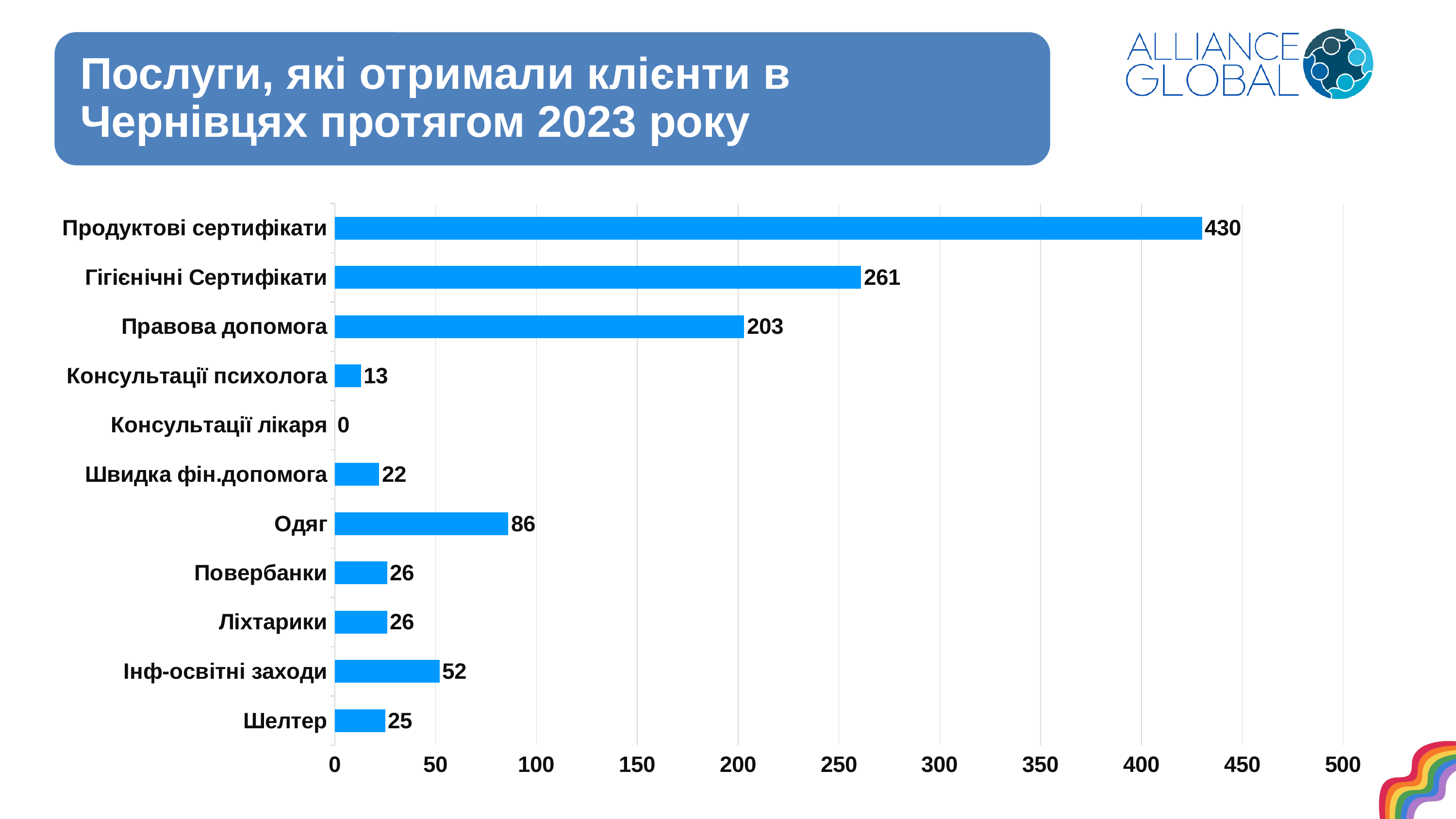
Which category has the lowest value? Консультації лікаря What value is shown for Одяг? 86 How many categories are shown on the chart? 11 Which is larger, Інф-освітні заходи or Шелтер? Інф-освітні заходи What is the title of the slide? Послуги, які отримали клієнти в Чернівцях протягом 2023 року Is the value for Гігієнічні Сертифікати greater or less than 250? greater Which category has the highest value? Продуктові сертифікати What value is shown for Консультації лікаря? 0 What is the difference between Продуктові сертифікати and Гігієнічні Сертифікати? 169 What value is shown for Продуктові сертифікати? 430 What kind of chart is shown on the slide? bar chart What value is shown for Правова допомога? 203